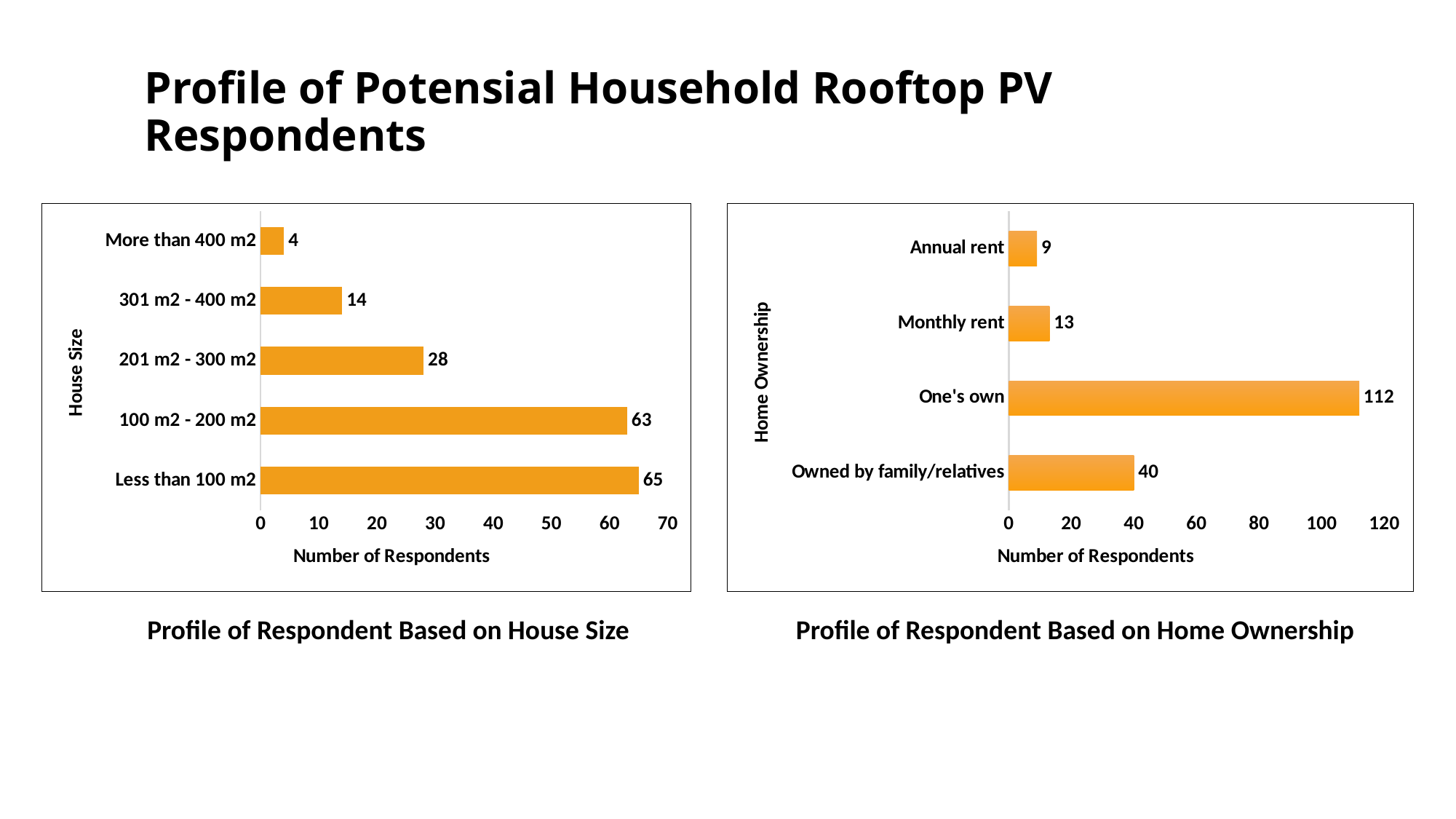
In the 'Profile of Respondent Based on Home Ownership' chart, what is the difference in respondents between 'One's own' and 'Owned by family/relatives'? 72 What type of chart is 'Profile of Respondent Based on House Size'? Bar chart In the 'Profile of Respondent Based on House Size' chart, what is the difference in respondents between 100 m2 - 200 m2 and 301 m2 - 400 m2? 49 In the 'Profile of Respondent Based on Home Ownership' chart, how many respondents are in the 'One's own' category? 112 In the 'Profile of Respondent Based on House Size' chart, which house size category has the most respondents? Less than 100 m2 In the 'Profile of Respondent Based on House Size' chart, which house size category has the fewest respondents? More than 400 m2 In the 'Profile of Respondent Based on Home Ownership' chart, which category has the fewest respondents? Annual rent In the 'Profile of Respondent Based on House Size' chart, how many respondents have a house size of 201 m2 - 300 m2? 28 In the 'Profile of Respondent Based on Home Ownership' chart, which has more respondents: Monthly rent or Annual rent? Monthly rent What is the x-axis label of the 'Profile of Respondent Based on Home Ownership' chart? Number of Respondents In the 'Profile of Respondent Based on Home Ownership' chart, how many respondents are in the 'Owned by family/relatives' category? 40 In the 'Profile of Respondent Based on House Size' chart, how many house size categories are shown? 5